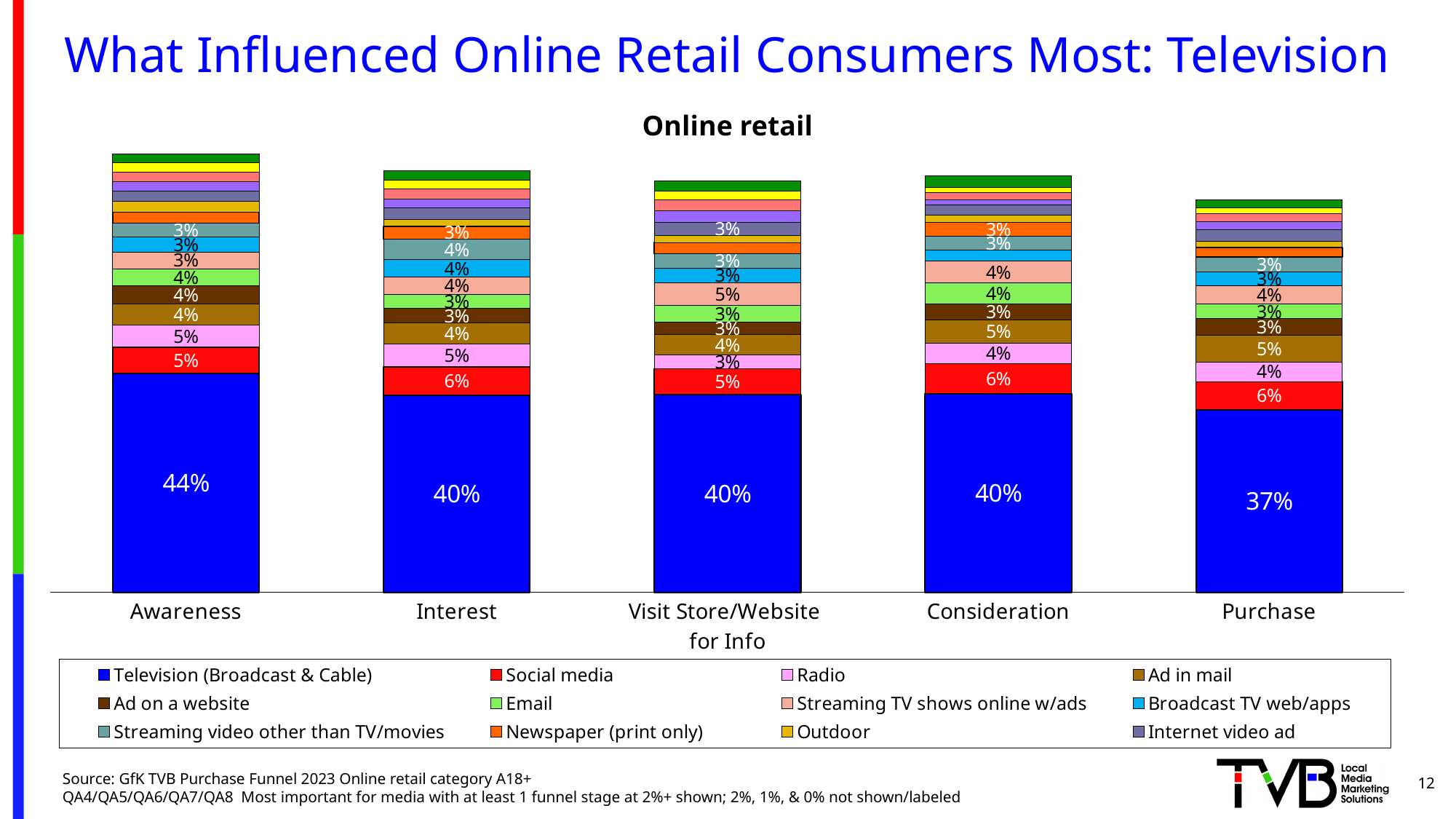
What percentage is shown for Television (Broadcast & Cable) at the Awareness stage? 44% How many funnel stages are shown on the x axis? 5 Is the Social media value larger at Awareness or at Interest? Interest At which funnel stage is the Television (Broadcast & Cable) share highest? Awareness How many percentage points higher is the Television share at Awareness than at Purchase? 7 percentage points What is the Streaming TV shows online w/ads value at the Visit Store/Website for Info stage? 5% Does the Television (Broadcast & Cable) share rise or fall from Awareness to Purchase? Fall How many media types does the legend list? 12 What percentage is shown for Television (Broadcast & Cable) at the Purchase stage? 37% At which funnel stage is the Television (Broadcast & Cable) share lowest? Purchase What is the Social media value at the Interest stage? 6% What kind of chart is shown on the slide? Stacked bar chart